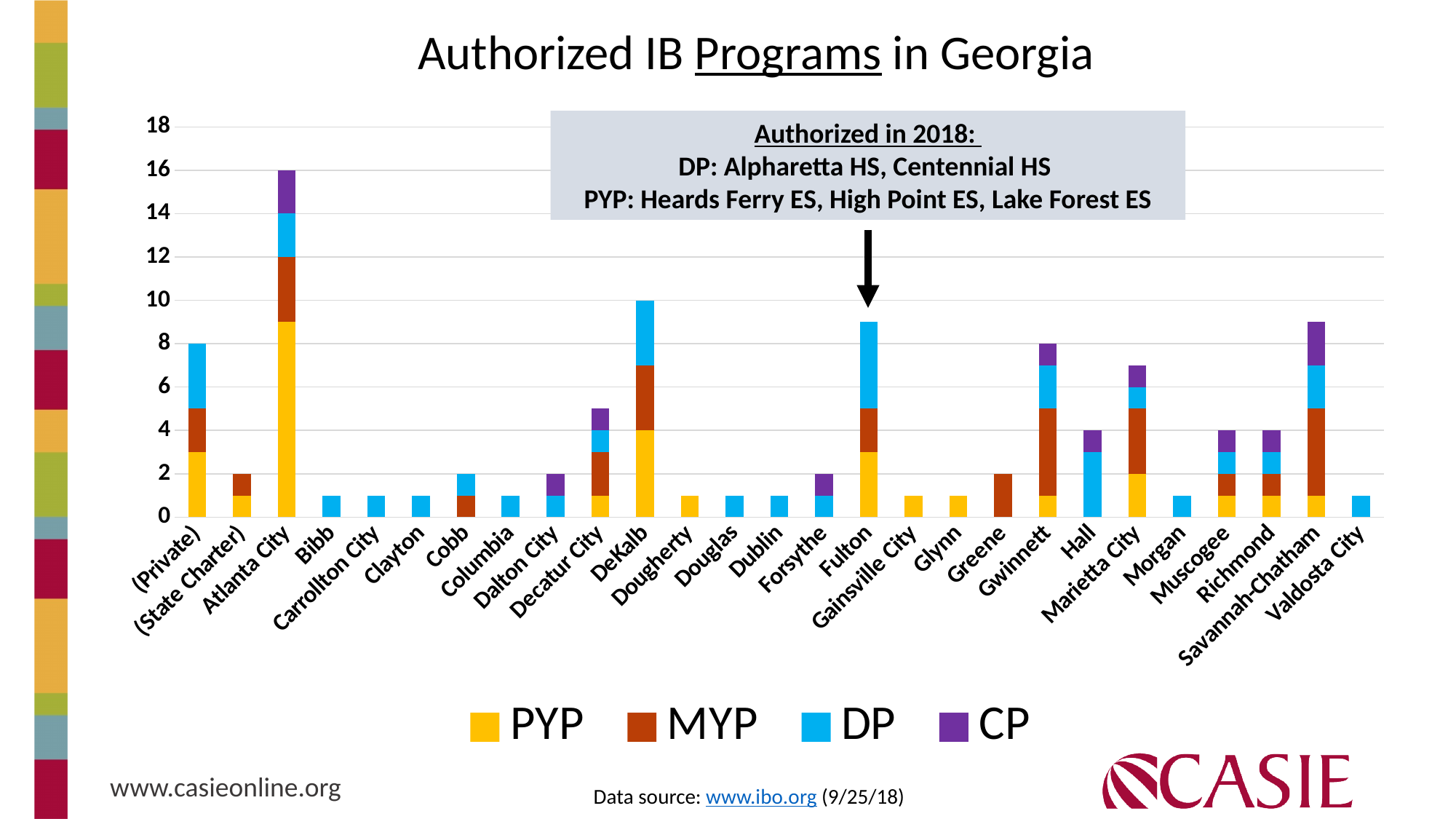
Is the total value for Fulton greater or less than 8? greater Is the total value for Marietta City greater or less than 8? less What is the difference between the total for Atlanta City and the total for DeKalb? 6 What kind of chart is shown on the slide? Stacked bar chart Which category has the highest total number of authorized IB programs? Atlanta City What is the total height of the stacked bar for Atlanta City? 16 What is the title of the chart? Authorized IB Programs in Georgia What is the total height of the stacked bar for DeKalb? 10 Which series are listed in the legend? PYP, MYP, DP, CP How many series does the legend list? 4 How many districts/categories are shown on the x axis? 27 Which has a larger total, DeKalb or Gwinnett? DeKalb